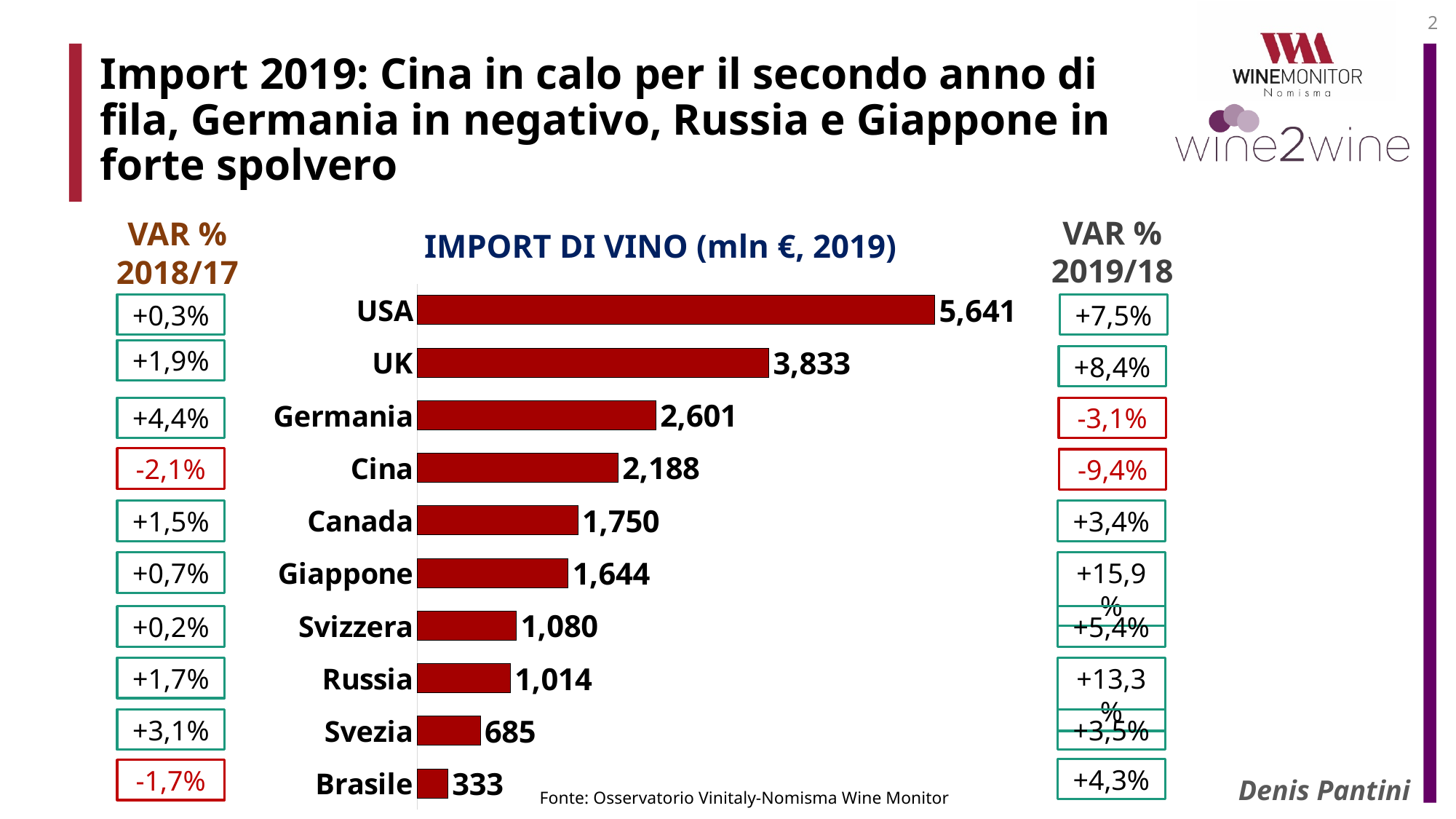
What is the title of the chart? IMPORT DI VINO (mln €, 2019) What is the wine import value for Giappone? 1,644 Do the import values rise or fall going from USA down to Brasile? fall What kind of chart is used to show the wine import values? bar chart What is the difference between the import values of USA and UK? 1,808 What is the difference between the import values of Cina and Canada? 438 Which has a larger import value, Svizzera or Russia? Svizzera Which country has the lowest wine import value in the chart? Brasile Which country has the highest wine import value in the chart? USA What is the wine import value for Germania in the chart? 2,601 How many countries are shown in the chart? 10 What is the VAR % 2019/18 shown for Cina? -9,4%